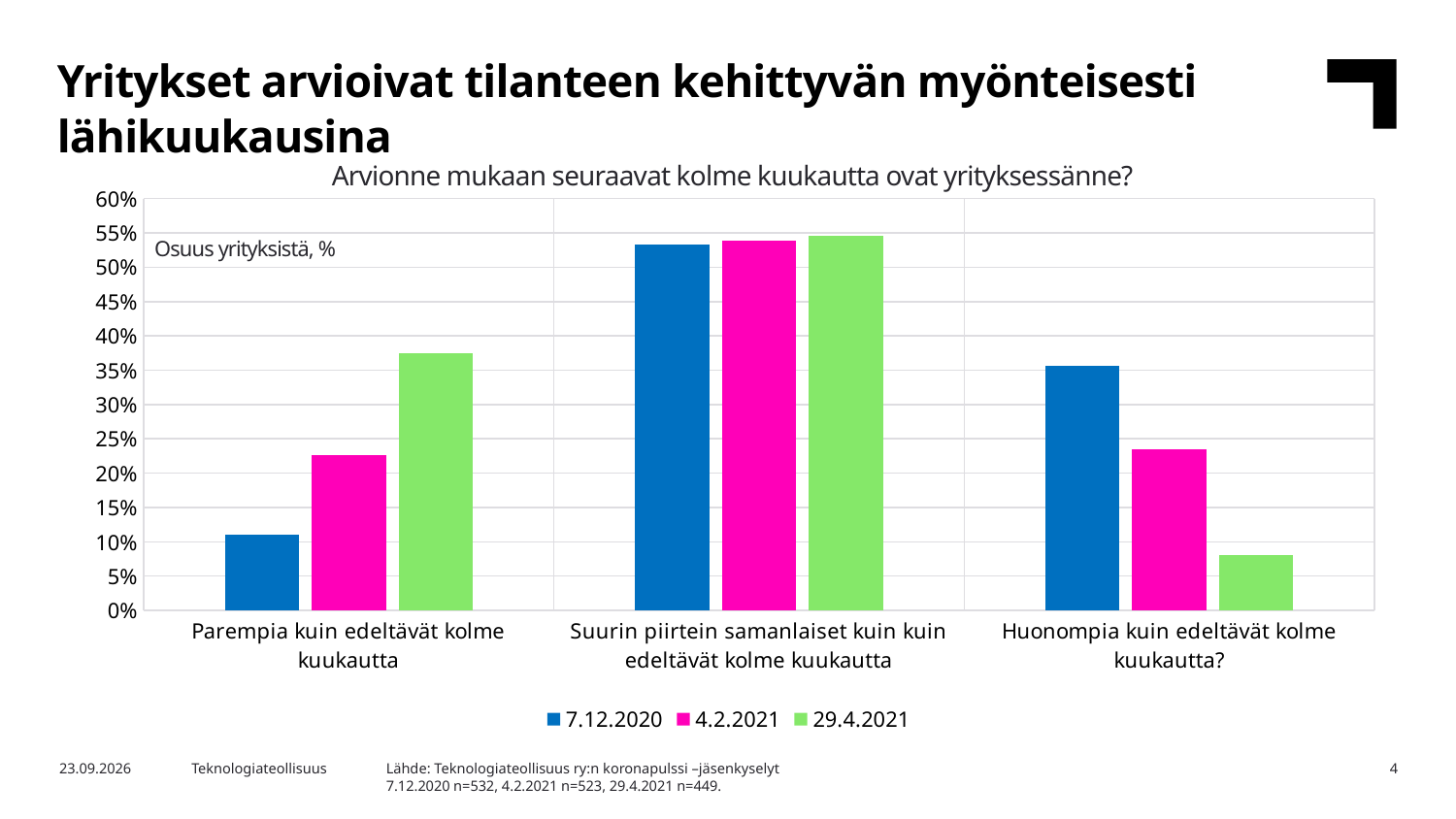
Which category has the lowest value for the 7.12.2020 series? Parempia kuin edeltävät kolme kuukautta What is the title of the chart? Arvionne mukaan seuraavat kolme kuukautta ovat yrityksessänne? For 'Huonompia kuin edeltävät kolme kuukautta?', which series has the larger value: 7.12.2020 or 4.2.2021? 7.12.2020 Is the value for 'Parempia kuin edeltävät kolme kuukautta' in the 29.4.2021 series greater or less than 35%? greater Is the value for 'Huonompia kuin edeltävät kolme kuukautta?' in the 29.4.2021 series greater or less than 10%? less For 'Parempia kuin edeltävät kolme kuukautta', do the values rise or fall from the 7.12.2020 series to the 29.4.2021 series? rise Which category has the lowest value for the 29.4.2021 series? Huonompia kuin edeltävät kolme kuukautta? How many categories are shown on the x axis? 3 What kind of chart is shown on the slide? bar chart Which category has the highest value for the 29.4.2021 series? Suurin piirtein samanlaiset kuin kuin edeltävät kolme kuukautta How many series does the legend list? 3 Is the value for 'Parempia kuin edeltävät kolme kuukautta' in the 7.12.2020 series greater or less than 15%? less